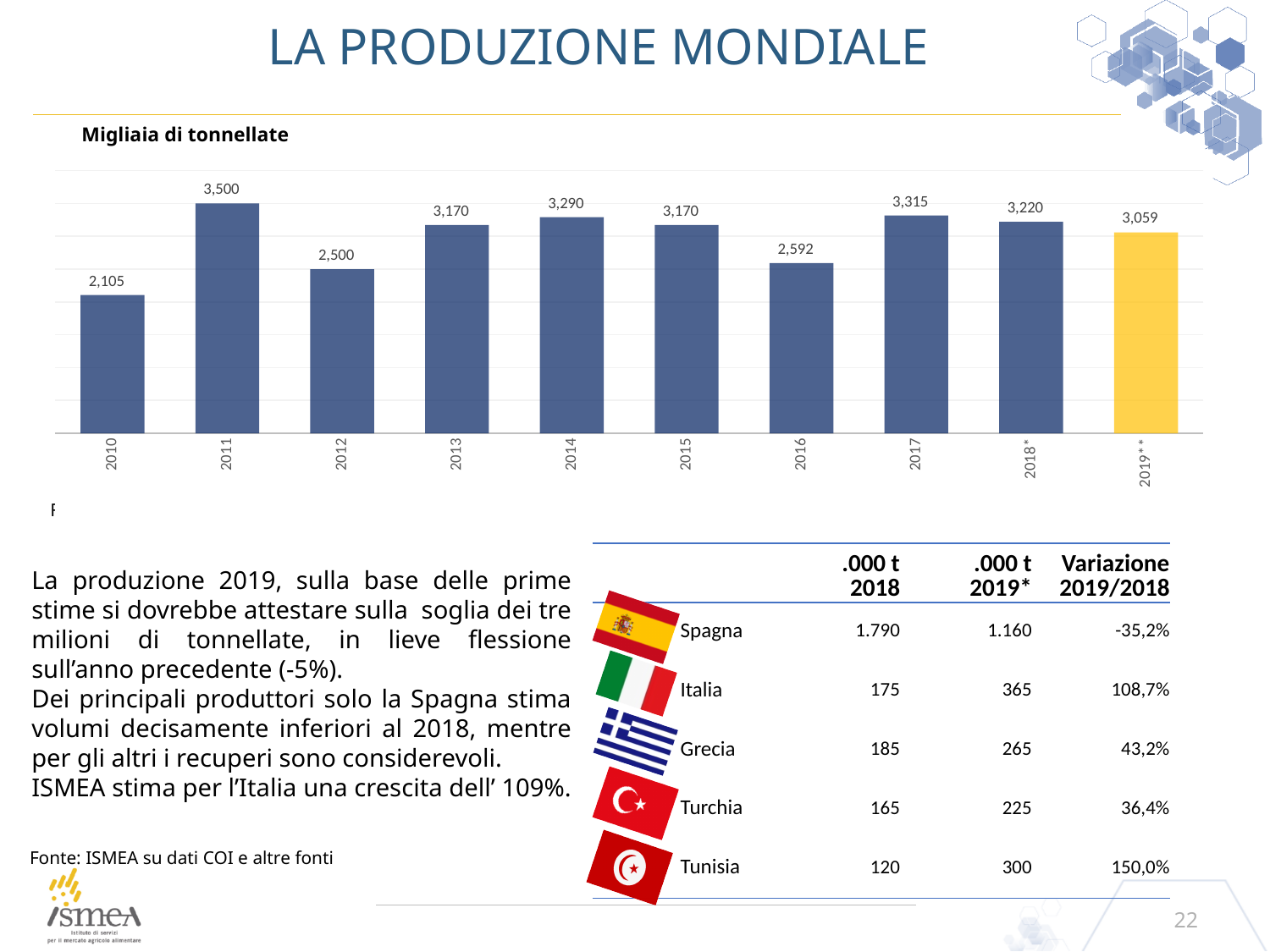
What is the value shown for 2010 in the bar chart? 2,105 Which year has the lowest value in the bar chart? 2010 Which is larger in the bar chart, the value for 2014 or the value for 2017? 2017 Which year has the highest value in the bar chart? 2011 What type of chart is shown on the slide? Bar chart What is the difference between the values for 2018* and 2019** in the bar chart? 161 What is the value shown for 2016 in the bar chart? 2,592 Does the value in the bar chart rise or fall from 2017 to 2019**? Fall How many years (bars) are shown in the bar chart? 10 What is the difference between the values for 2011 and 2012 in the bar chart? 1,000 Which bar in the chart is coloured yellow instead of blue? 2019** What is the value shown for 2019** in the bar chart? 3,059